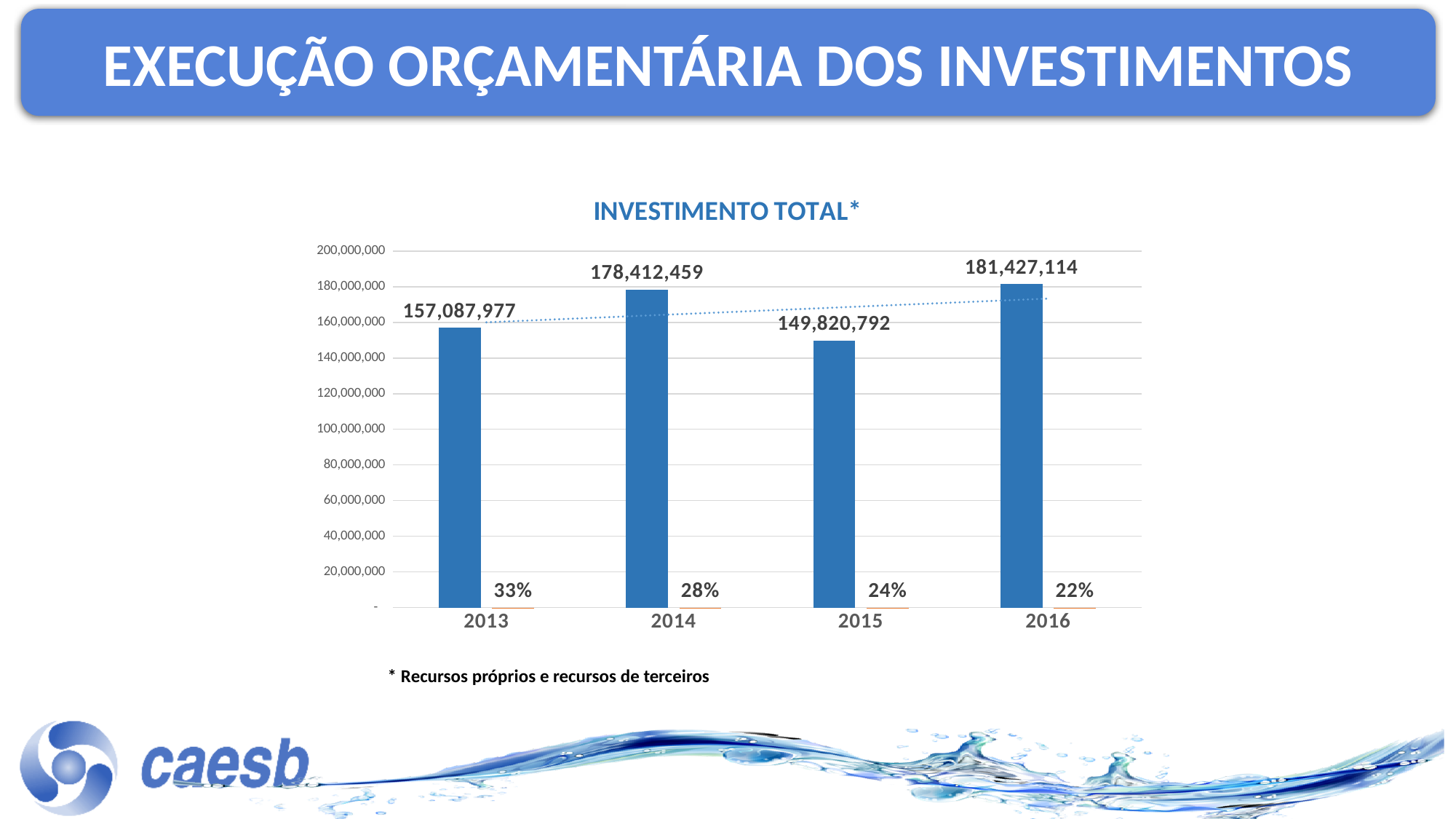
Which is larger, the investment total for 2013 or for 2015? 2013 What is the investment total for 2015? 149,820,792 What is the difference between the investment totals for 2013 and 2015? 7,267,185 What percentage is shown at the base of the 2016 bar? 22% What is the title of the chart? INVESTIMENTO TOTAL* How many years are shown on the x axis? 4 Which year has the highest investment total? 2016 What kind of chart is shown on the slide? Bar chart What is the difference between the investment totals for 2016 and 2014? 3,014,655 What is the investment total for 2014? 178,412,459 Which year has the lowest investment total? 2015 What percentage is shown at the base of the 2013 bar? 33%